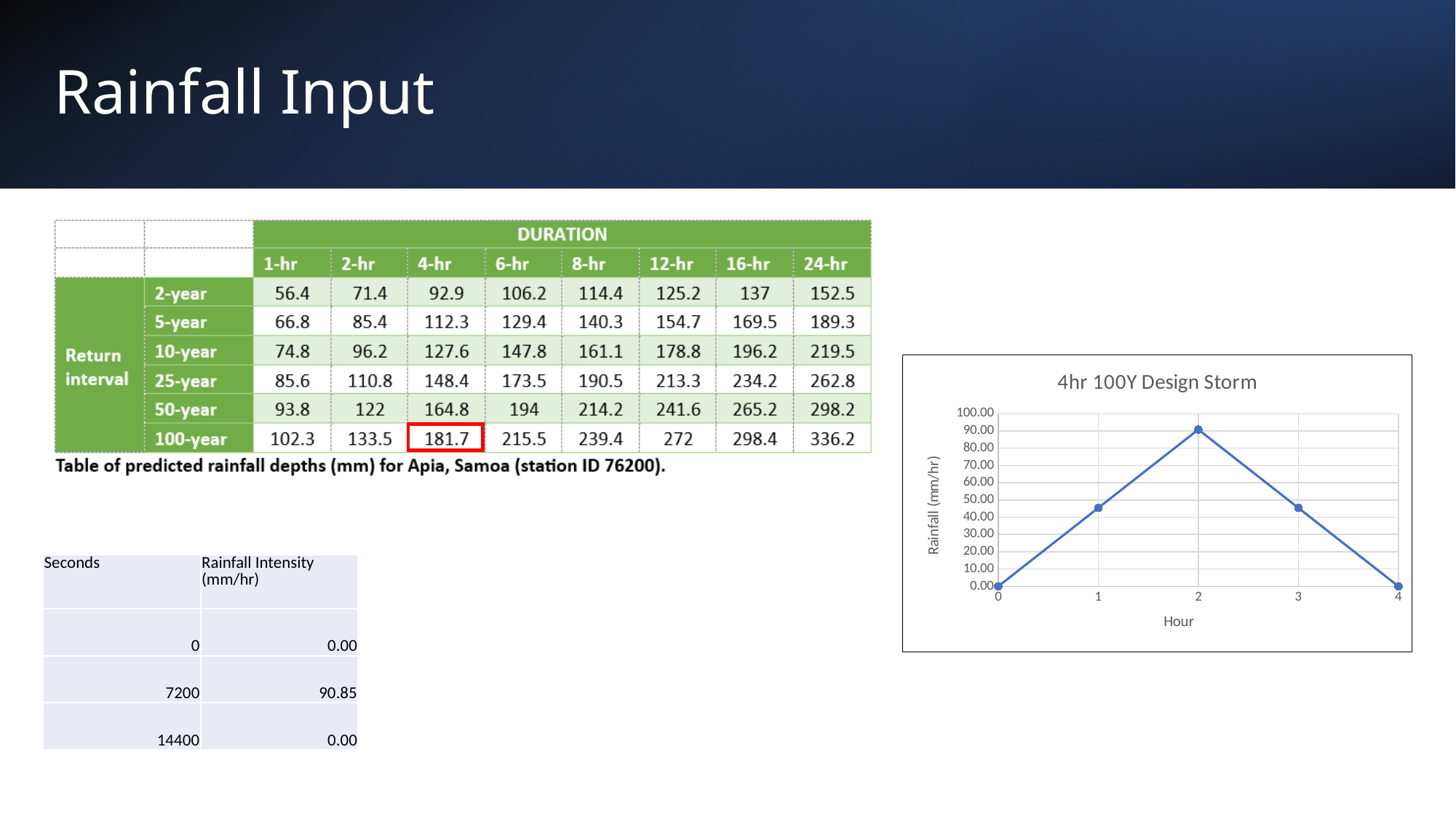
On the "4hr 100Y Design Storm" chart, do the rainfall values rise or fall from hour 2 to hour 4? fall What is the label of the vertical axis on the "4hr 100Y Design Storm" chart? Rainfall (mm/hr) What is the title of the chart on the right of the slide? 4hr 100Y Design Storm On the "4hr 100Y Design Storm" chart, what is the rainfall value at hour 4? 0.00 On the "4hr 100Y Design Storm" chart, is the rainfall value at hour 2 greater or less than 80.00? greater How many data points are plotted on the "4hr 100Y Design Storm" chart? 5 On the "4hr 100Y Design Storm" chart, which has the larger rainfall value: hour 2 or hour 1? hour 2 At which hour does the "4hr 100Y Design Storm" chart reach its highest rainfall value? 2 On the "4hr 100Y Design Storm" chart, is the rainfall value at hour 3 greater or less than 40.00? greater On the "4hr 100Y Design Storm" chart, what is the rainfall value at hour 0? 0.00 What kind of chart is the "4hr 100Y Design Storm" chart? line chart On the "4hr 100Y Design Storm" chart, is the rainfall value at hour 1 greater or less than 50.00? less